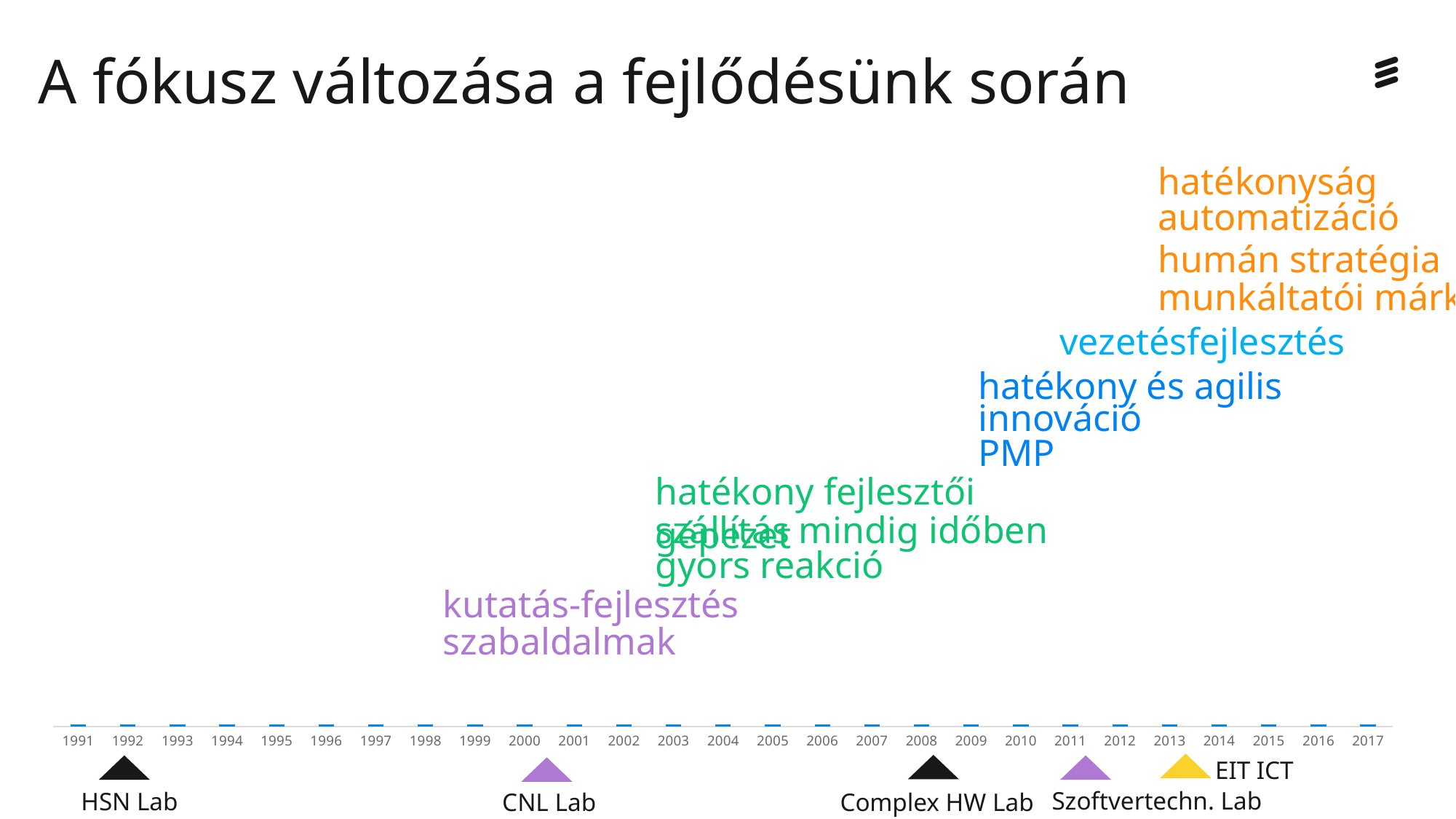
What is the first year shown on the x axis of the timeline chart? 1991 What colour is the text 'kutatás-fejlesztés' above the timeline? Purple Under which year is the HSN Lab marker placed on the timeline? 1992 How many year labels are shown along the x axis of the timeline chart? 27 Under which year is the EIT ICT marker placed on the timeline? 2013 Under which year is the Complex HW Lab marker placed on the timeline? 2008 How many lab markers (triangles) are placed below the timeline? 5 Under which year is the Szoftvertechn. Lab marker placed on the timeline? 2011 What is the last year shown on the x axis of the timeline chart? 2017 Under which year is the CNL Lab marker placed on the timeline? 2001 What is the title of the slide containing the timeline chart? A fókusz változása a fejlődésünk során